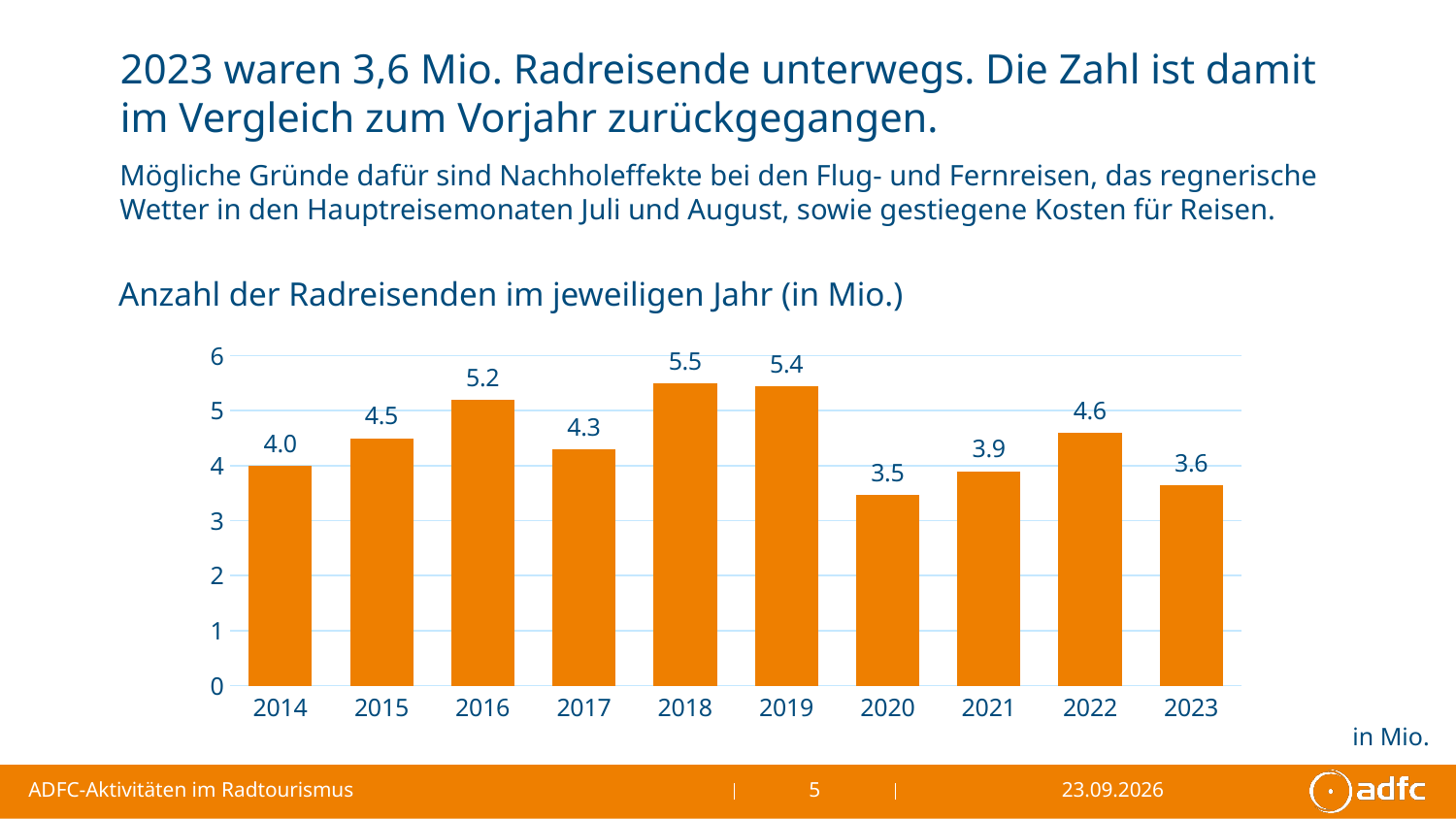
Is the value for 2019 greater or less than 5? greater What is the value for 2023? 3.6 What is the value for 2020? 3.5 How many years are shown on the x axis? 10 Which year has the highest value? 2018 Which year has the lowest value? 2020 Which is larger, the value for 2016 or the value for 2017? 2016 What is the title of the chart? Anzahl der Radreisenden im jeweiligen Jahr (in Mio.) What is the difference between the values for 2022 and 2023? 1.0 What is the difference between the values for 2018 and 2020? 2.0 What is the value for 2018? 5.5 What kind of chart is shown on the slide? bar chart